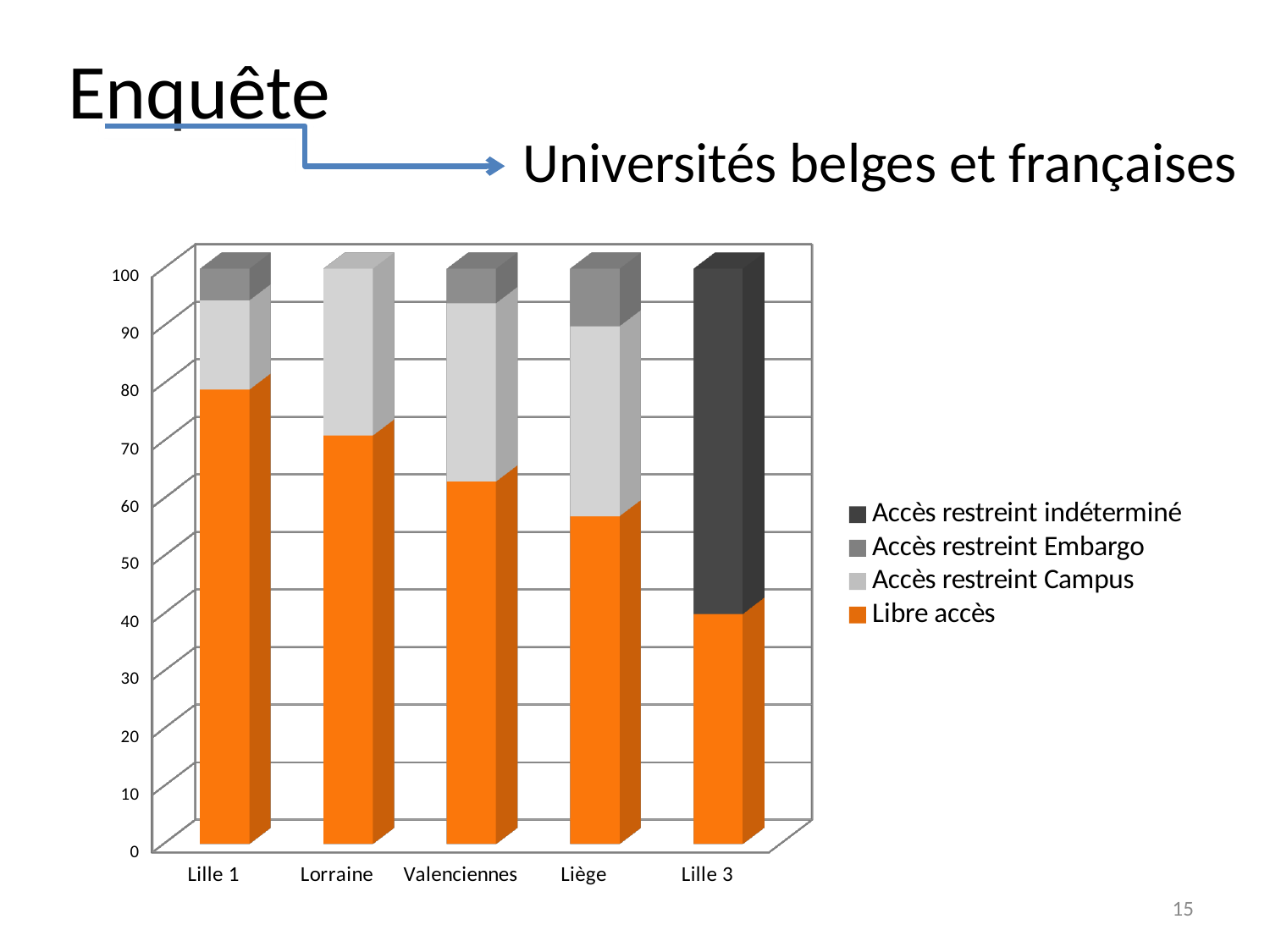
Is the Libre accès value for Lille 1 greater or less than 70? greater Which has a larger Libre accès value, Lorraine or Liège? Lorraine Is the Libre accès value for Lille 3 greater or less than 50? less Which university has the lowest value for Libre accès? Lille 3 What kind of chart is shown on the slide? stacked bar chart How many universities (categories) are shown on the x axis? 5 Is the Libre accès value for Valenciennes greater or less than 70? less How many series does the legend list? 4 Does the Libre accès value rise or fall from Lille 1 to Lille 3 along the x axis? fall Which university's bar contains the Accès restreint indéterminé series? Lille 3 Which university has the highest value for Libre accès? Lille 1